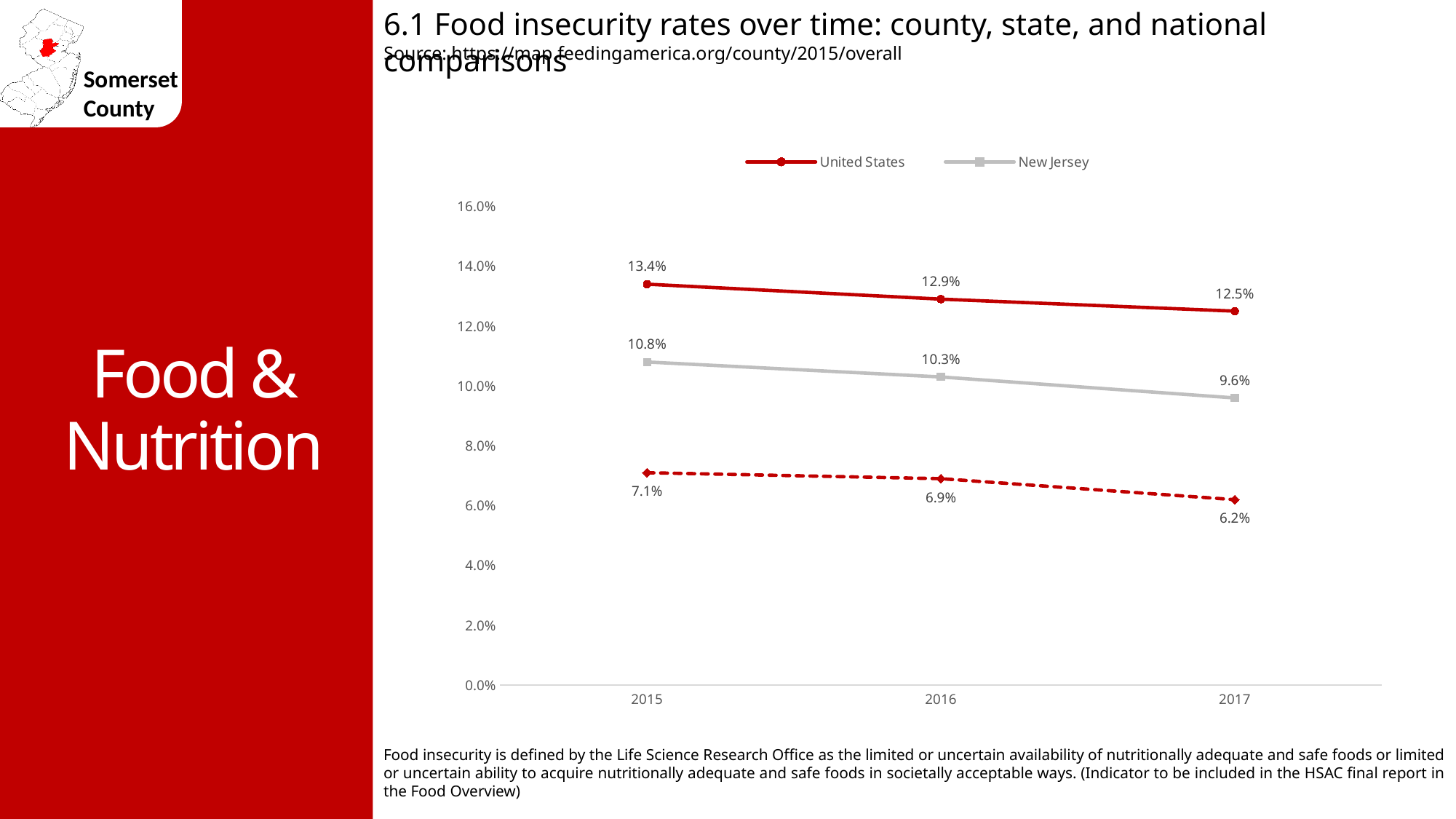
What was the food insecurity rate for New Jersey in 2017? 9.6% What was the food insecurity rate for the United States in 2015? 13.4% By how much did the United States food insecurity rate fall from 2015 to 2017? 0.9 percentage points What kind of chart is shown on the slide? Line chart In which year was the New Jersey food insecurity rate highest? 2015 How many series does the legend list? 2 In 2016, which had the higher food insecurity rate, the United States or New Jersey? United States What was the food insecurity rate for New Jersey in 2016? 10.3% What was the food insecurity rate for the United States in 2017? 12.5% What is the difference between the United States and New Jersey food insecurity rates in 2016? 2.6 percentage points How many years are shown on the x axis? 3 Does the United States food insecurity rate rise or fall from 2015 to 2017? Fall